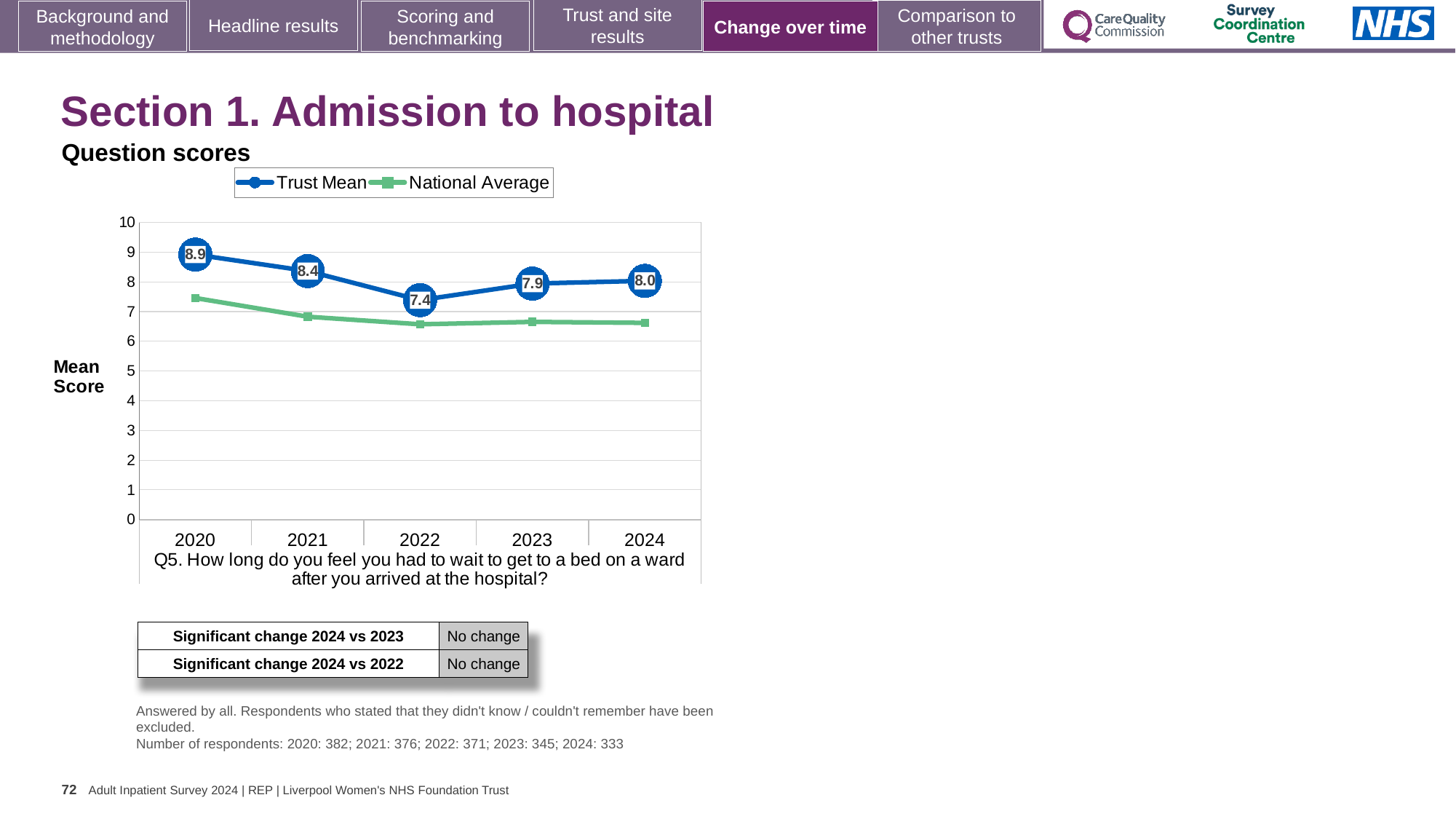
Which is larger, the Trust Mean score for 2021 or for 2023? 2021 What kind of chart is shown? line chart Is the National Average value for 2022 greater or less than 7? less Is the National Average value for 2020 greater or less than 7? greater What is the Trust Mean score for 2024? 8.0 How many years are shown on the x axis? 5 What is the Trust Mean score for 2022? 7.4 In which year is the Trust Mean score lowest? 2022 What is the difference between the Trust Mean scores for 2020 and 2022? 1.5 How many series does the legend list? 2 What is the Trust Mean score for 2020? 8.9 In which year is the Trust Mean score highest? 2020